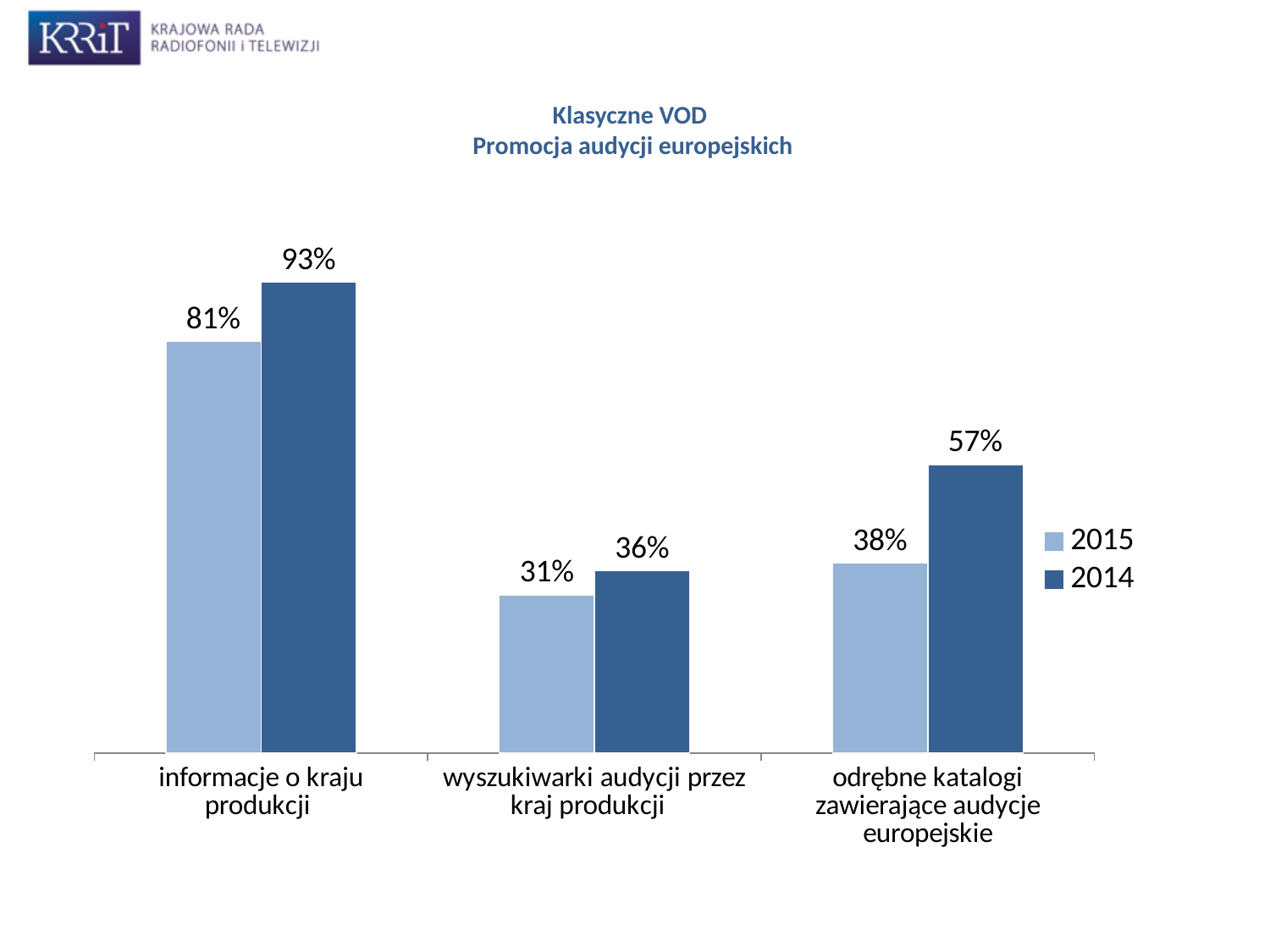
What is the 2015 value for "informacje o kraju produkcji"? 81% Which is larger for "wyszukiwarki audycji przez kraj produkcji": the 2015 value or the 2014 value? 2014 What is the 2015 value for "wyszukiwarki audycji przez kraj produkcji"? 31% What is the 2014 value for "odrębne katalogi zawierające audycje europejskie"? 57% How many categories are shown on the x axis? 3 What is the difference between the 2014 and 2015 values for "informacje o kraju produkcji"? 12% What is the title of the chart? Klasyczne VOD Promocja audycji europejskich What kind of chart is shown on the slide? bar chart How many series does the legend list? 2 Which category has the lowest 2015 value? wyszukiwarki audycji przez kraj produkcji What is the difference between the 2014 and 2015 values for "odrębne katalogi zawierające audycje europejskie"? 19% Which category has the highest 2014 value? informacje o kraju produkcji